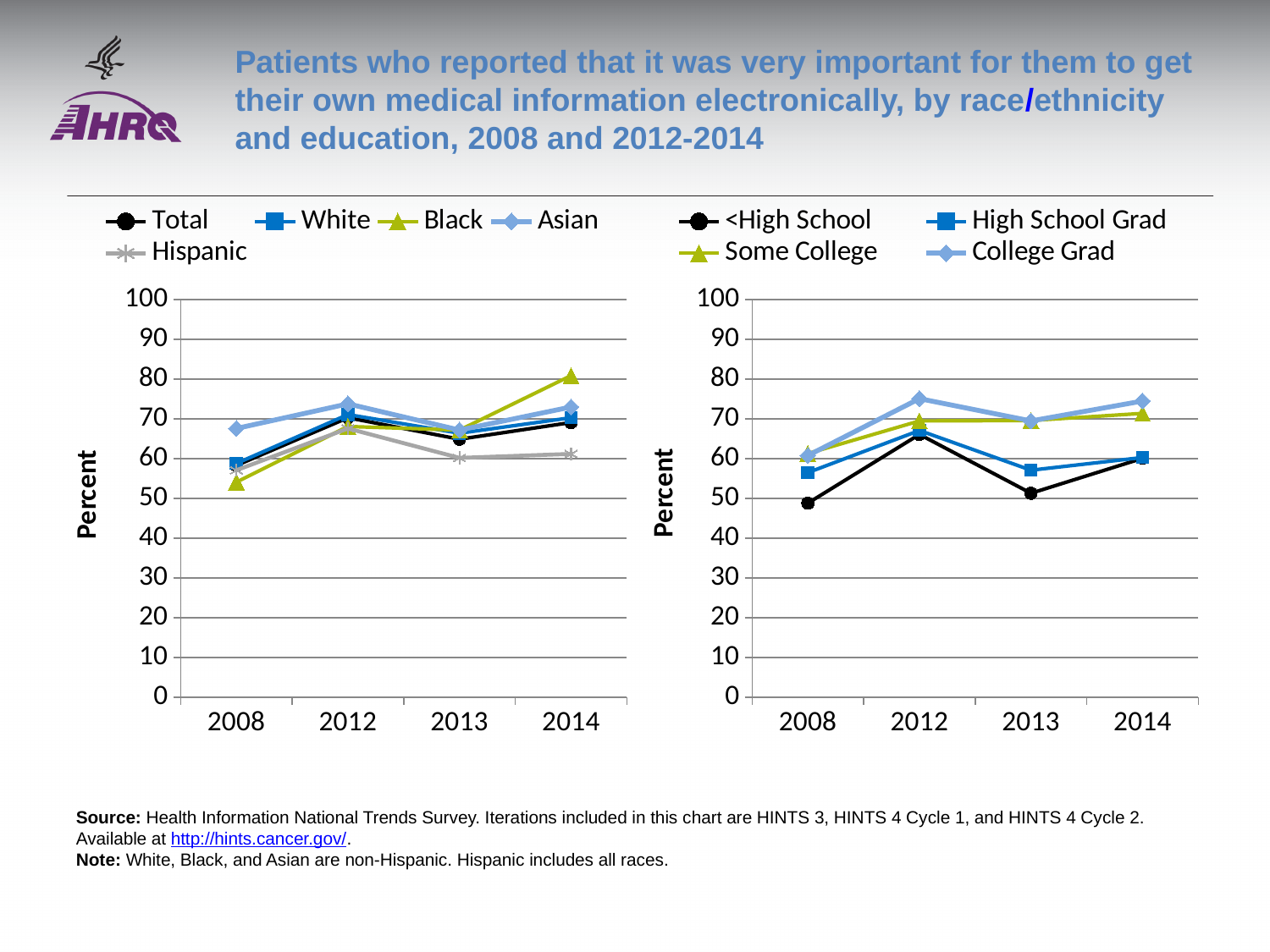
How many years are shown on the x axis of the right chart (by education)? 4 In the left chart (by race/ethnicity), which group has the highest value in 2014? Black In the left chart (by race/ethnicity), which group has the lowest value in 2013? Hispanic In the right chart (by education), which group has the highest value in 2012? College Grad In the right chart (by education), is the value for <High School in 2008 greater or less than 60? less How many series does the legend of the right chart (by education) list? 4 What kind of chart is the left chart (by race/ethnicity)? line chart In the right chart (by education), does the value for <High School rise or fall from 2012 to 2013? fall How many series does the legend of the left chart (by race/ethnicity) list? 5 In the left chart (by race/ethnicity), is the value for Black in 2008 greater or less than 60? less In the left chart (by race/ethnicity), which group has the lowest value in 2008? Black